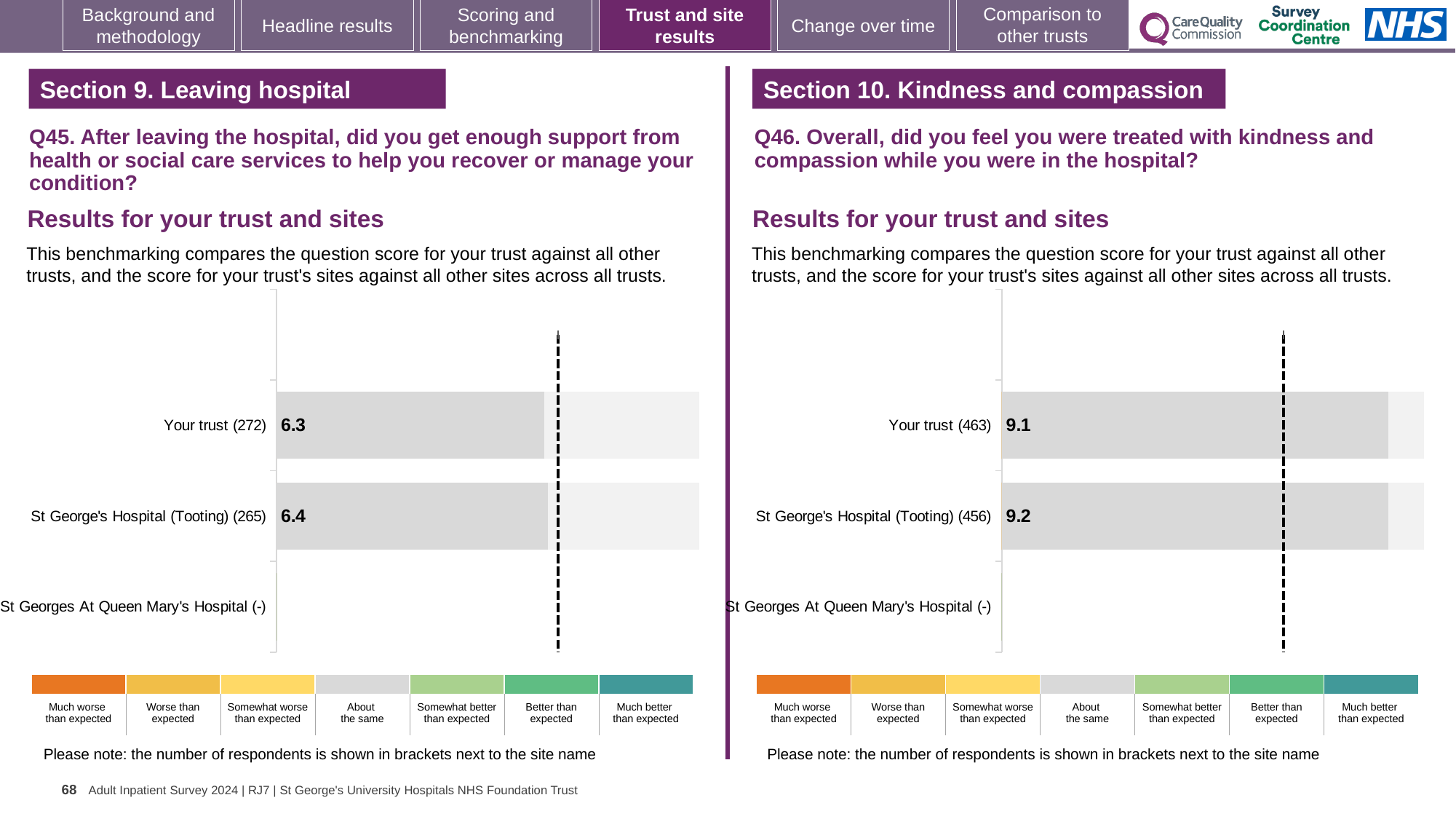
On the Q46 chart (right), what is the score for St George's Hospital (Tooting)? 9.2 On the Q46 chart (right), how many respondents are shown in brackets for St George's Hospital (Tooting)? 456 On the Q46 chart (right), what is the score for Your trust? 9.1 On the Q45 chart (left), which has the higher score, Your trust or St George's Hospital (Tooting)? St George's Hospital (Tooting) On the Q45 chart (left), what is the score for St George's Hospital (Tooting)? 6.4 On the Q46 chart (right), what is the difference between the score for St George's Hospital (Tooting) and the score for Your trust? 0.1 How many site/trust categories are listed on the Q46 chart (right)? 3 What kind of chart is used for the Q45 results (left)? Bar chart On the Q46 chart (right), which category has the lowest printed score? Your trust On the Q45 chart (left), what is the score for Your trust? 6.3 On the Q45 chart (left), what is the difference between the score for St George's Hospital (Tooting) and the score for Your trust? 0.1 On the Q45 chart (left), how many respondents are shown in brackets for Your trust? 272